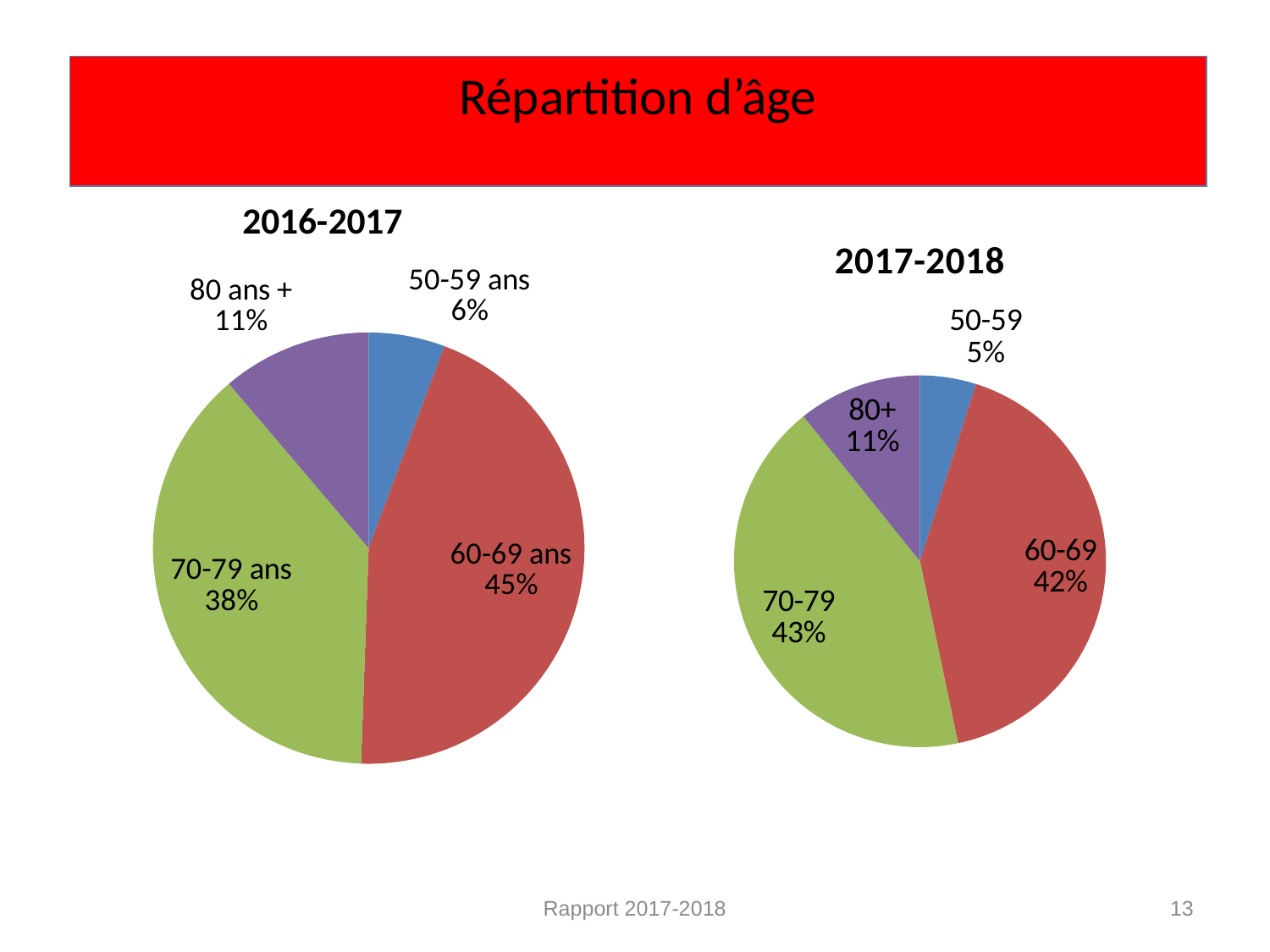
How many slices does the 2017-2018 pie chart have? 4 What type of chart is used for the 2016-2017 data? Pie chart In the 2017-2018 pie chart, what share is shown for 80+? 11% In the 2016-2017 pie chart, what share is shown for 50-59 ans? 6% In the 2017-2018 pie chart, what share is shown for 70-79? 43% In the 2017-2018 pie chart, which is larger: the share for 70-79 or the share for 60-69? 70-79 In the 2017-2018 pie chart, which age group has the smallest share? 50-59 In the 2016-2017 pie chart, which age group has the largest share? 60-69 ans In the 2016-2017 pie chart, what is the difference in percentage points between the 60-69 ans share and the 70-79 ans share? 7 percentage points What is the title of the chart on the right side of the slide? 2017-2018